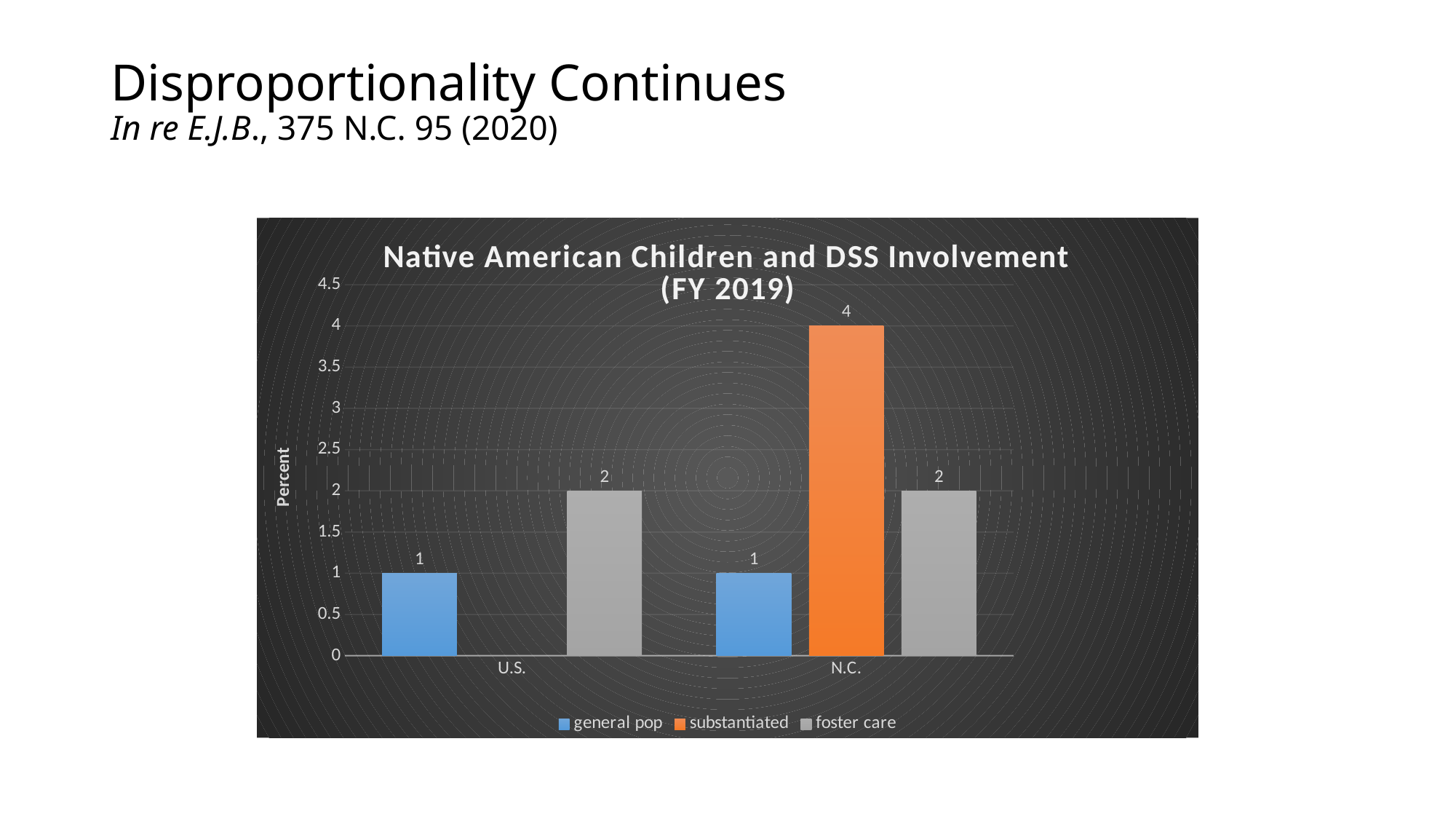
What is the title of the chart? Native American Children and DSS Involvement (FY 2019) Which is larger in the U.S. category: general pop or foster care? foster care Which series has the highest value in the N.C. category? substantiated What is the value for foster care in the N.C. category? 2 What kind of chart is shown on the slide? bar chart How many categories are shown on the x axis? 2 What is the value for general pop in the U.S. category? 1 What is the value for foster care in the U.S. category? 2 What is the value for substantiated in the N.C. category? 4 What is the difference between the substantiated value and the general pop value in the N.C. category? 3 Is the value for substantiated in N.C. greater or less than 3? greater How many series does the legend list? 3